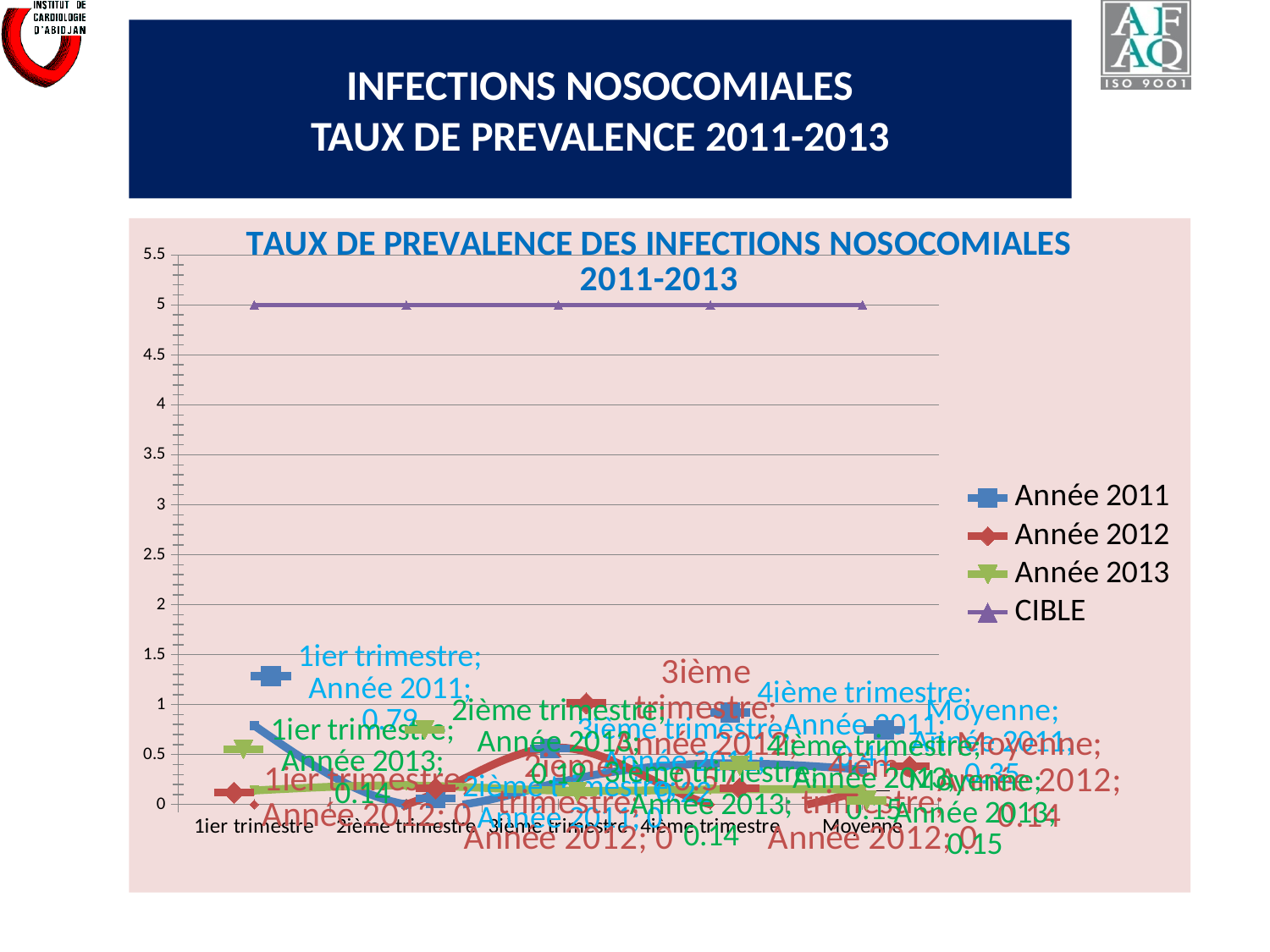
What is the difference between Année 2011 and Année 2013 in 1ier trimestre? 0.65 Which series has the highest values on the chart? CIBLE What is the value for Année 2013 in 1ier trimestre? 0.14 How many categories are shown along the x axis? 5 How many series does the legend list? 4 What kind of chart is shown on the slide? line chart What is the title of the chart? TAUX DE PREVALENCE DES INFECTIONS NOSOCOMIALES 2011-2013 Does the CIBLE line rise, fall or stay flat across the x axis? stays flat Is the value for CIBLE greater or less than 4.5? greater Which is larger in 1ier trimestre: Année 2011 or Année 2013? Année 2011 What is the value of the CIBLE series at each point? 5 What is the value for Année 2011 in 1ier trimestre? 0.79